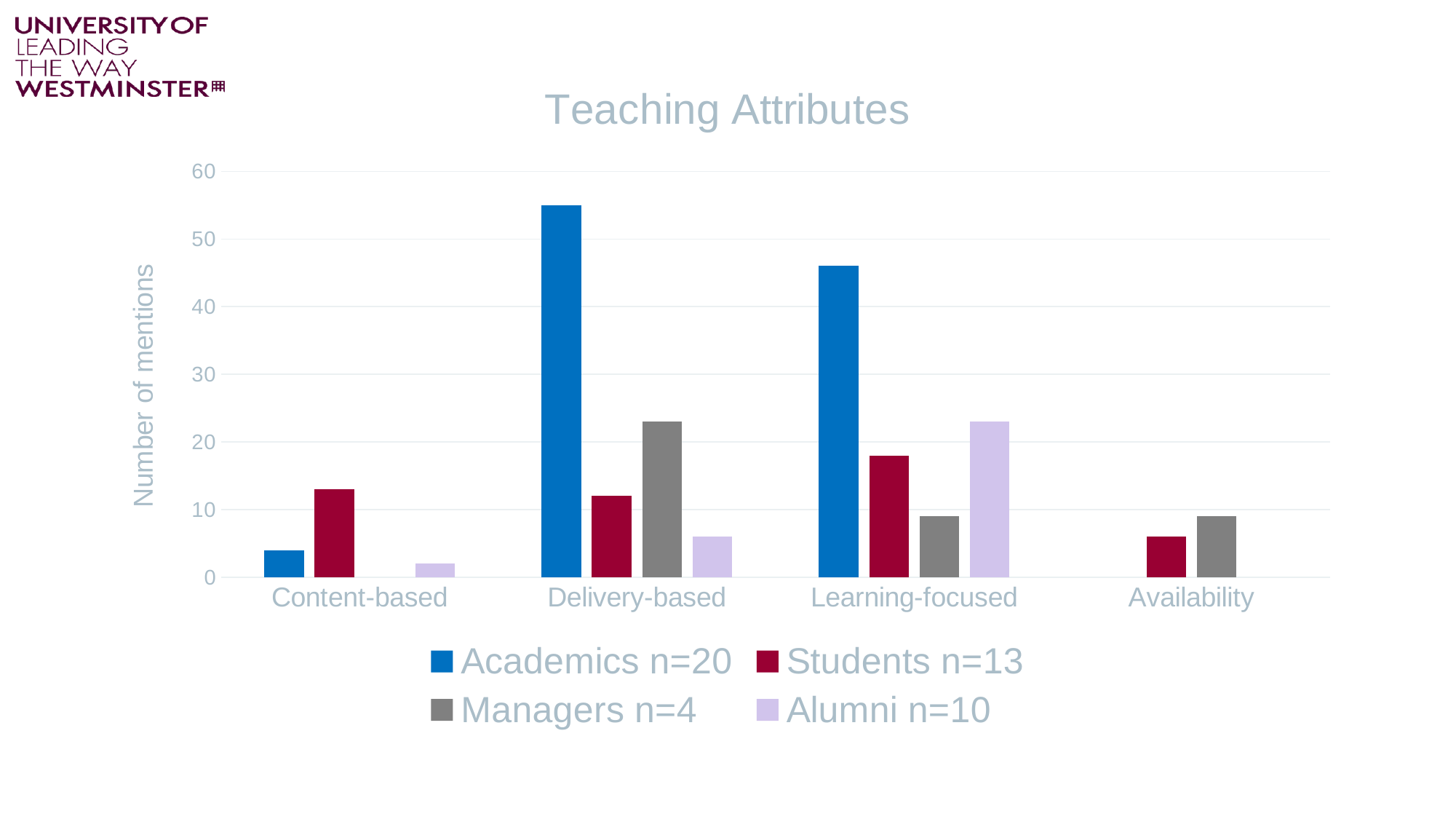
How many categories are shown on the x axis of the Teaching Attributes chart? 4 For Students n=13, which is larger: the value for Delivery-based or the value for Learning-focused? Learning-focused Is the value for Academics n=20 in Delivery-based greater or less than 50? greater Is the value for Students n=13 in Learning-focused greater or less than 20? less What is the title of the chart? Teaching Attributes Is the value for Managers n=4 in Delivery-based greater or less than 20? greater In which category is the Academics n=20 bar highest? Delivery-based How many series does the legend of the Teaching Attributes chart list? 4 What is the label on the vertical axis of the chart? Number of mentions What kind of chart is shown on the slide? bar chart Which series has the highest bar in the Content-based category? Students n=13